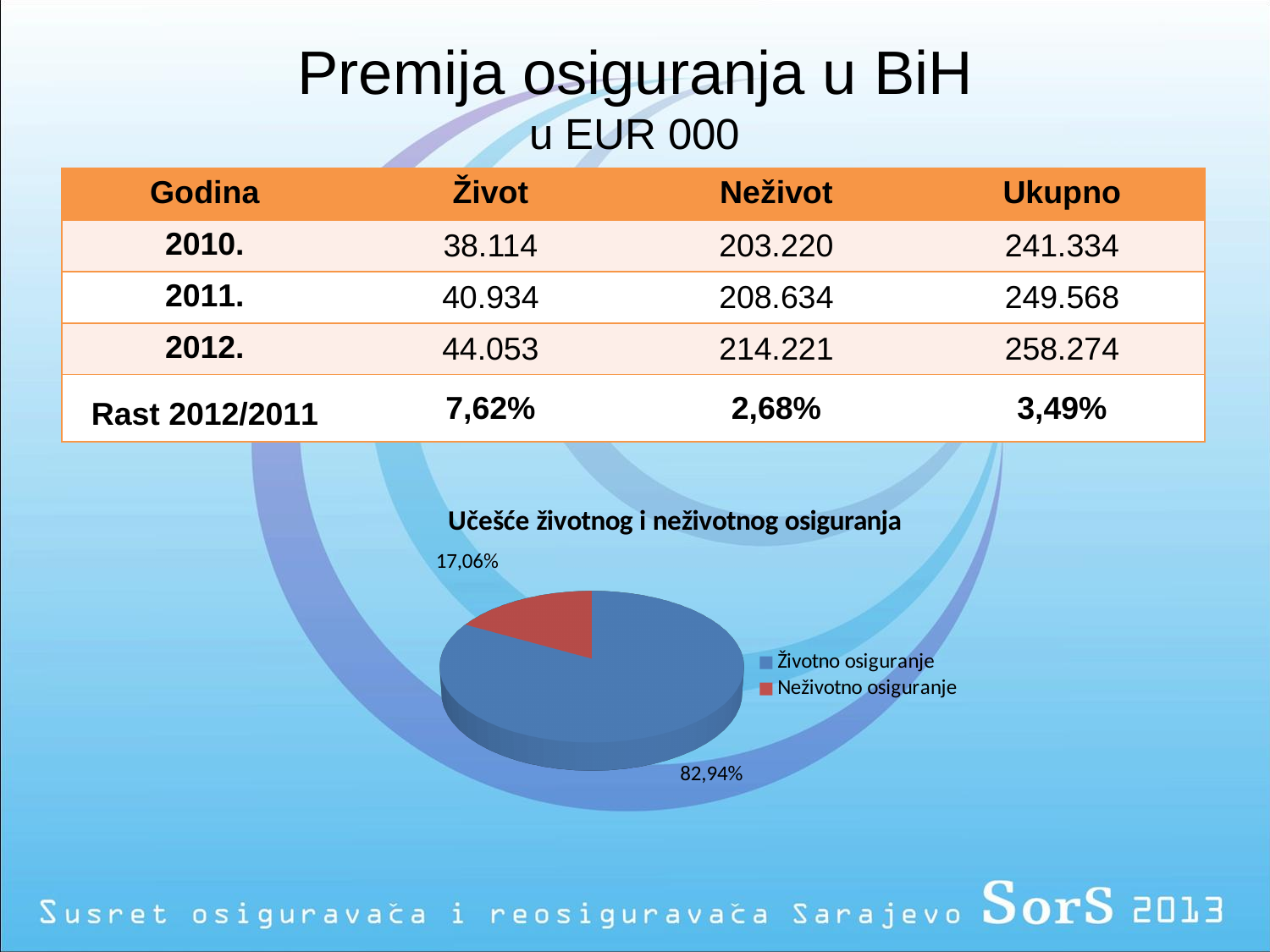
What percentage is shown on the larger (blue) slice of the pie chart? 82,94% What kind of chart is shown under the title "Učešće životnog i neživotnog osiguranja"? pie chart Which colour slice of the pie chart is the largest? blue What is the title of the pie chart on the slide? Učešće životnog i neživotnog osiguranja What is the difference in percentage points between the two slices of the pie chart (82,94% and 17,06%)? 65,88 How many slices does the pie chart "Učešće životnog i neživotnog osiguranja" have? 2 Which is larger in the pie chart, the blue slice or the red slice? blue slice What percentage is shown on the smaller (red) slice of the pie chart? 17,06% How many entries does the legend of the pie chart list? 2 What are the two legend entries of the pie chart? Životno osiguranje, Neživotno osiguranje Is the share of the red slice in the pie chart greater or less than 50%? less Which colour slice of the pie chart is the smallest? red